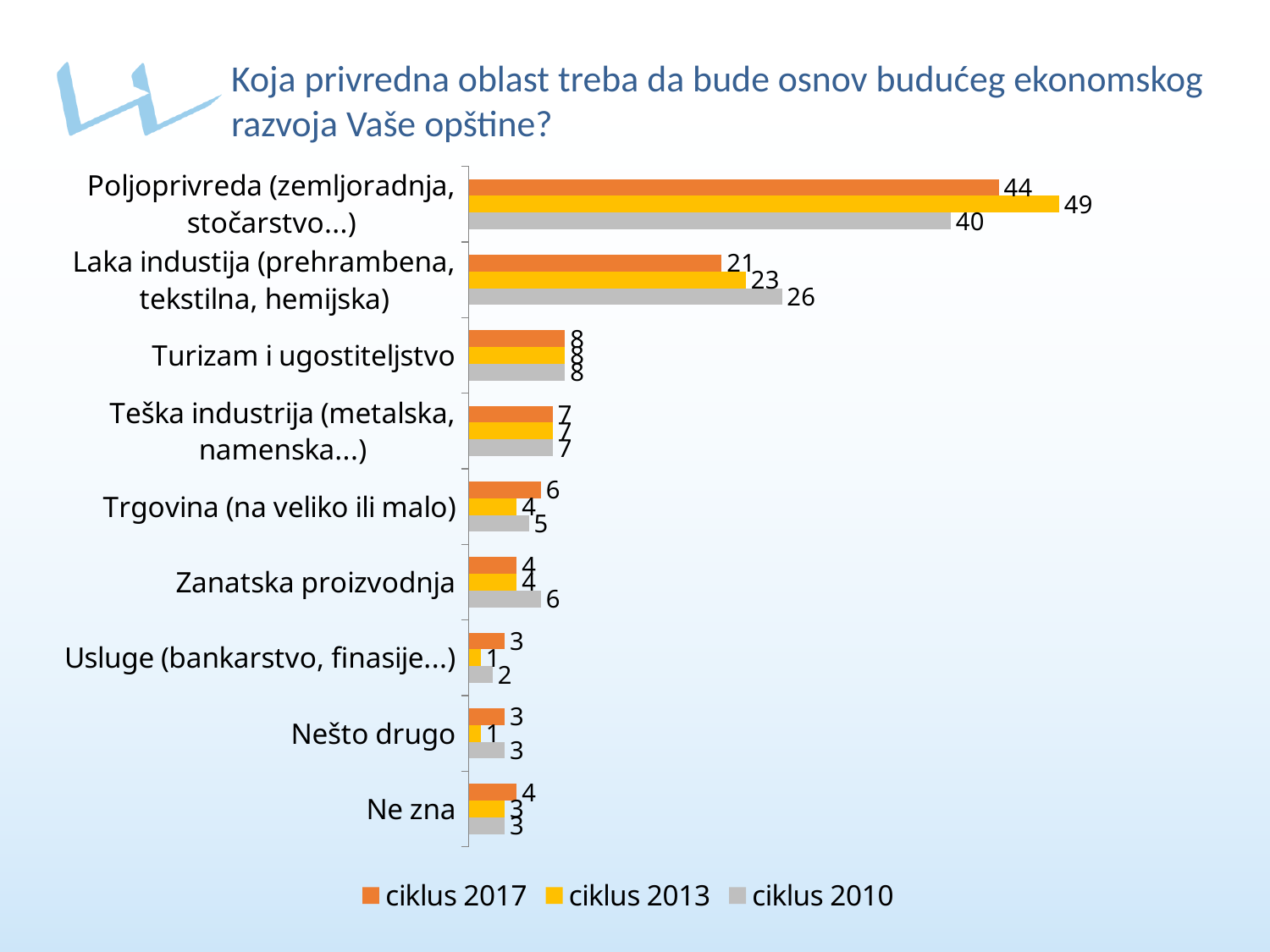
Which category has the lowest value in the ciklus 2010 series? Usluge (bankarstvo, finasije...) What type of chart is shown on the slide? bar chart What is the difference between the ciklus 2017 and ciklus 2013 values for Trgovina (na veliko ili malo)? 2 How many categories are shown on the chart? 9 Which colour represents the ciklus 2010 series in the legend? gray For Laka industija (prehrambena, tekstilna, hemijska), which series has the larger value: ciklus 2017 or ciklus 2010? ciklus 2010 How many series does the legend list? 3 Which category has the highest value in the ciklus 2017 series? Poljoprivreda (zemljoradnja, stočarstvo...) What is the value for Poljoprivreda (zemljoradnja, stočarstvo...) in the ciklus 2013 series? 49 What is the value for Laka industija (prehrambena, tekstilna, hemijska) in the ciklus 2010 series? 26 What is the difference between the ciklus 2013 and ciklus 2010 values for Poljoprivreda (zemljoradnja, stočarstvo...)? 9 What is the value for Usluge (bankarstvo, finasije...) in the ciklus 2013 series? 1